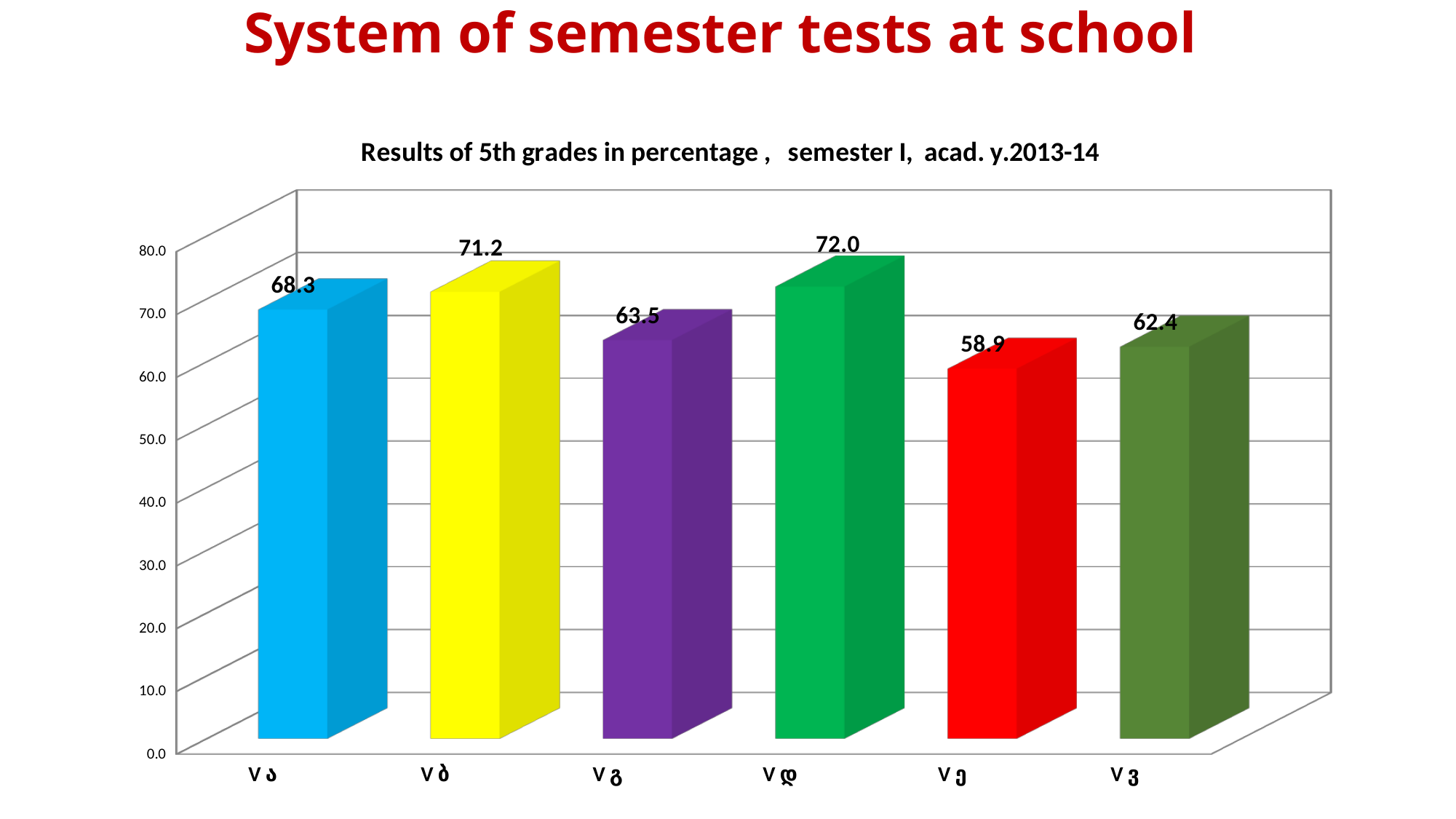
How many classes are shown on the chart? 6 What is the value for V ა? 68.3 What colour is the bar for V დ? green What is the title of the chart? Results of 5th grades in percentage , semester I, acad. y.2013-14 Which is larger, the value for V ა or the value for V ვ? V ა What is the difference between the values for V ბ and V გ? 7.7 Which class has the highest result? V დ What kind of chart is shown on the slide? bar chart Which class has the lowest result? V ე What is the value for V ე? 58.9 Is the value for V ე greater or less than 60.0? less What is the value for V დ? 72.0